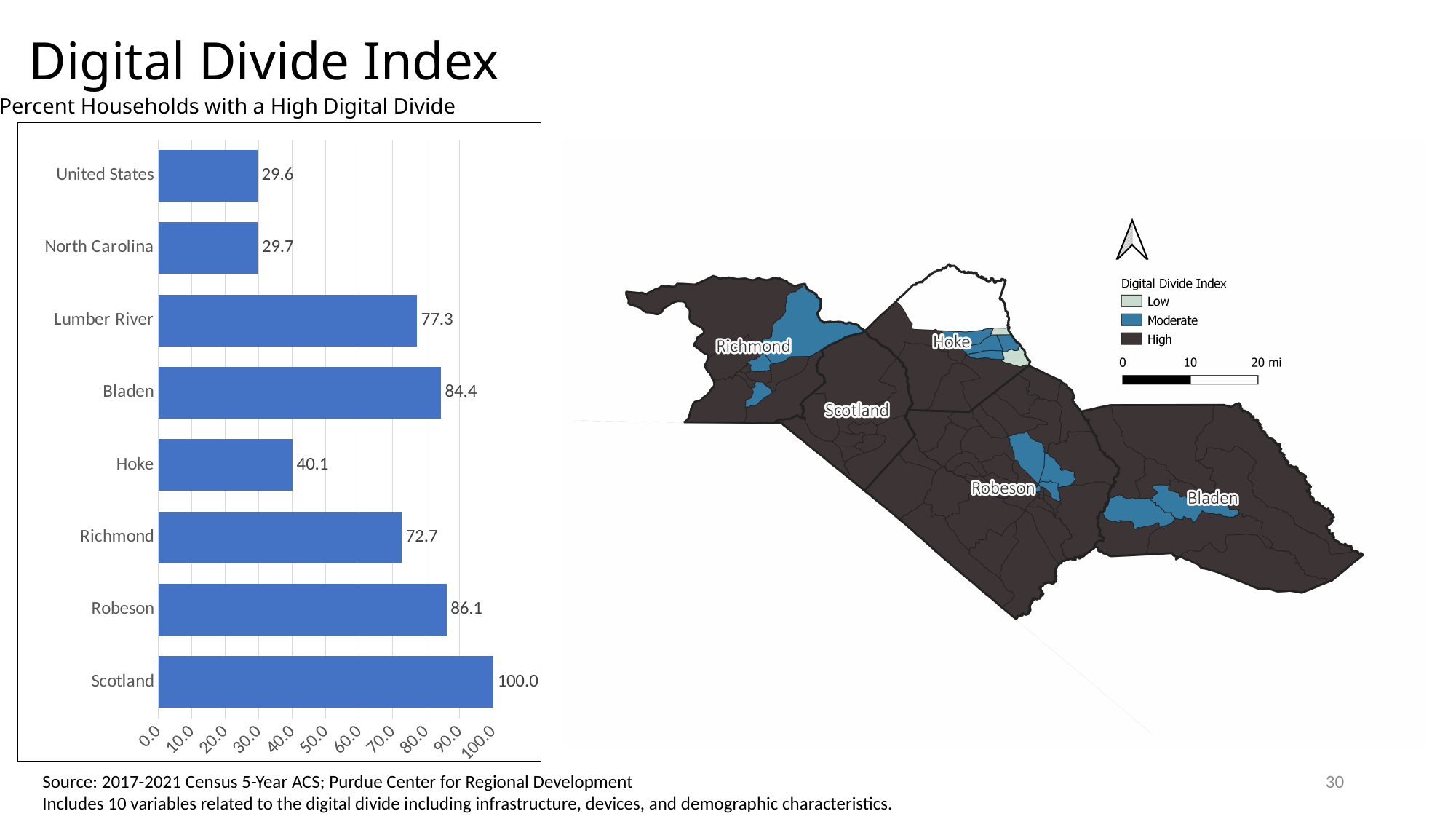
What kind of chart is shown on the left of the slide? bar chart In the bar chart, what is the value for Lumber River? 77.3 In the bar chart, is the value for Richmond greater or less than 70.0? greater In the bar chart, what is the difference between the values for Bladen and Hoke? 44.3 In the bar chart, what is the difference between the values for Scotland and Robeson? 13.9 How many categories are shown in the bar chart? 8 In the bar chart, what is the value for Hoke? 40.1 What three categories does the map legend for the Digital Divide Index list? Low, Moderate, High In the bar chart, which is larger, the value for Robeson or the value for Bladen? Robeson In the bar chart, which category has the highest value? Scotland In the bar chart, which is larger, the value for Richmond or the value for Lumber River? Lumber River In the bar chart, what is the value for North Carolina? 29.7